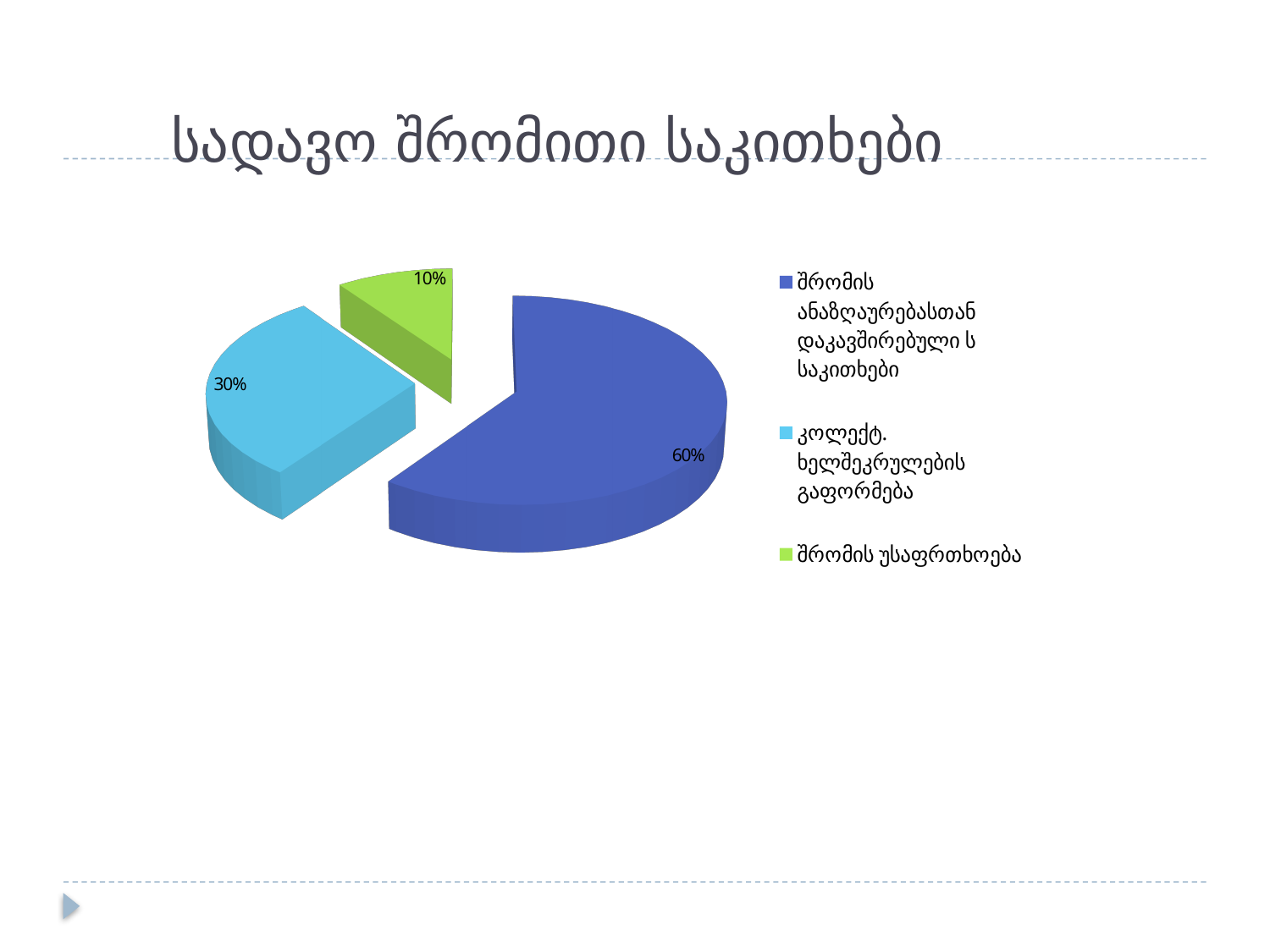
What share of the pie does "კოლექტ. ხელშეკრულების გაფორმება" take? 30% What share of the pie does "შრომის უსაფრთხოება" take? 10% What colour is the slice for "შრომის უსაფრთხოება"? green How many slices does the pie chart have? 3 What is the difference in percentage points between the largest slice (60%) and the slice for "კოლექტ. ხელშეკრულების გაფორმება"? 30 Which is larger: the slice for "კოლექტ. ხელშეკრულების გაფორმება" or the slice for "შრომის უსაფრთხოება"? კოლექტ. ხელშეკრულების გაფორმება Which category has the smallest slice of the pie? შრომის უსაფრთხოება What share of the pie does "შრომის ანაზღაურებასთან დაკავშირებული საკითხები" take? 60% What is the title of the slide containing the pie chart? სადავო შრომითი საკითხები What kind of chart is shown on the slide? pie chart Which category has the largest slice of the pie? შრომის ანაზღაურებასთან დაკავშირებული საკითხები How many entries does the legend list? 3